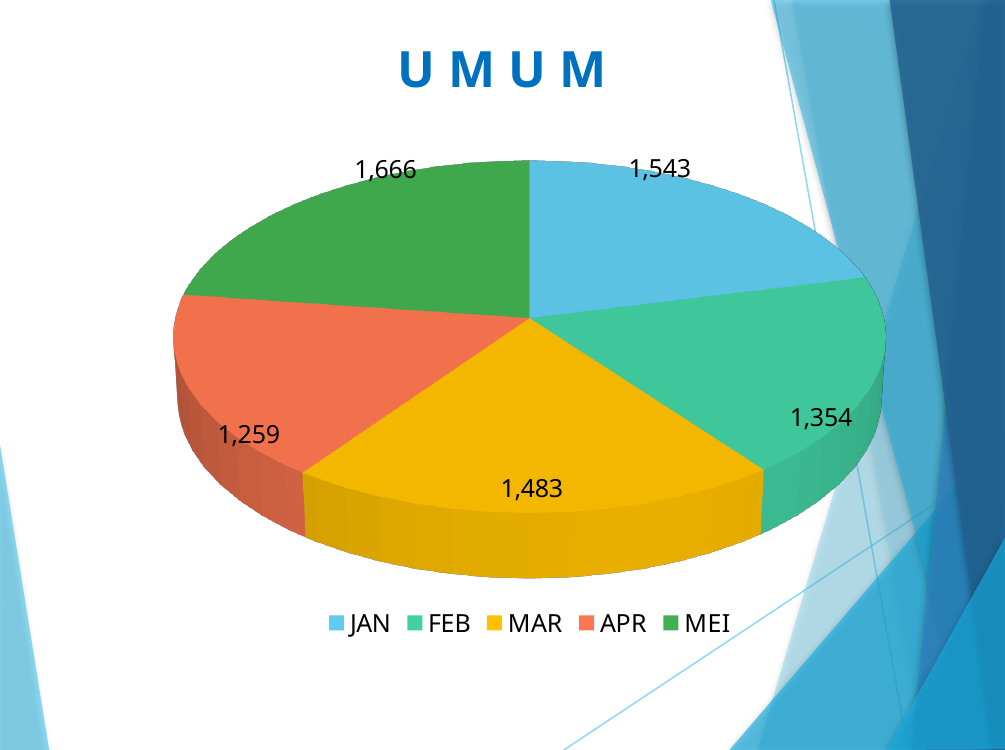
What is the difference between the values for MEI and APR? 407 Which colour represents MEI in the legend? Green What is the value for MAR? 1,483 What type of chart is shown on the slide? Pie chart What is the title of the chart? UMUM Which month has the largest slice? MEI How many slices does the pie chart have? 5 Which month has the smallest slice? APR What is the value for JAN? 1,543 Which is larger, the value for FEB or the value for MAR? MAR What is the difference between the values for JAN and FEB? 189 What is the value for APR? 1,259